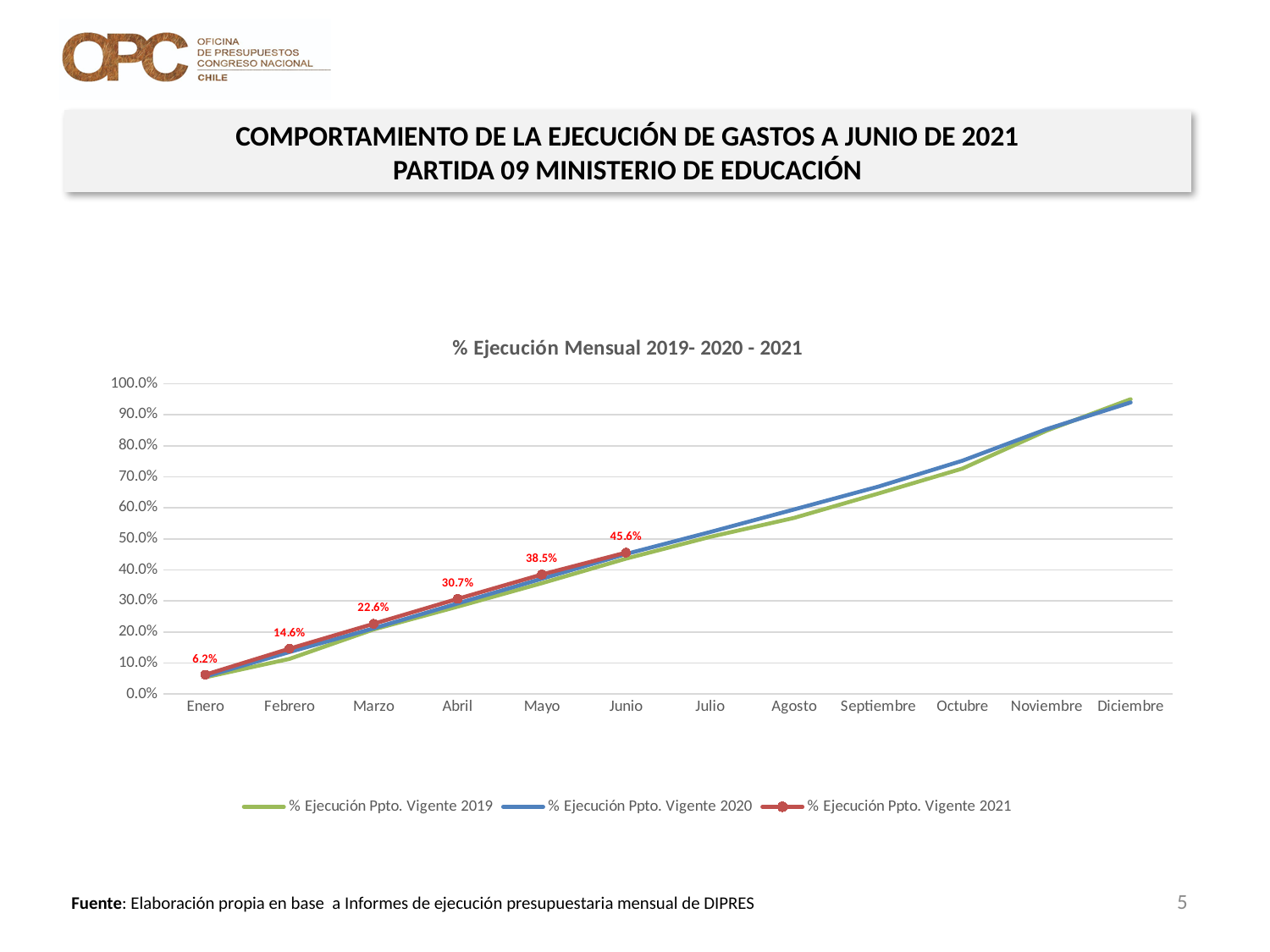
What is the difference between the 2021 values for Junio and Mayo? 7.1% What is the value of % Ejecución Ppto. Vigente 2021 for Marzo? 22.6% How many series does the legend list? 3 What is the title of the chart? % Ejecución Mensual 2019- 2020 - 2021 Is the value of % Ejecución Ppto. Vigente 2020 for Diciembre greater or less than 90.0%? greater What is the value of % Ejecución Ppto. Vigente 2021 for Enero? 6.2% How many months are shown on the x axis? 12 Is the value of % Ejecución Ppto. Vigente 2019 for Agosto greater or less than 60.0%? less Does the % Ejecución Ppto. Vigente 2021 series rise or fall from Enero to Junio? rise What type of chart is shown on the slide? line chart What is the difference between the 2021 values for Abril and Febrero? 16.1% What is the value of % Ejecución Ppto. Vigente 2021 for Junio? 45.6%